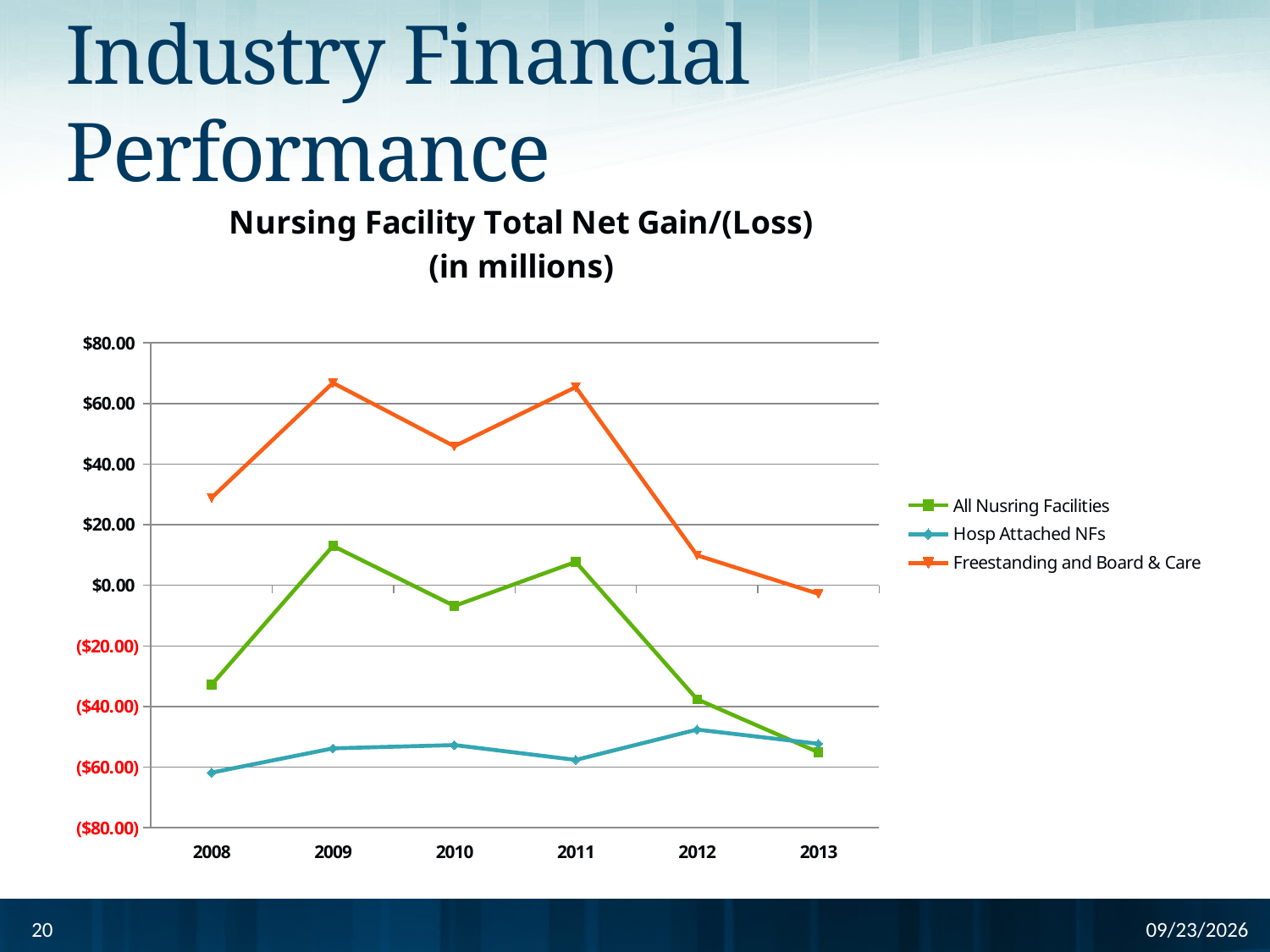
In 2009, which series has the larger value: All Nusring Facilities or Hosp Attached NFs? All Nusring Facilities What kind of chart is shown on the slide? line chart Which year has the lowest value for the Freestanding and Board & Care series? 2013 Is the value for Hosp Attached NFs in 2008 greater or less than ($40.00)? less Does the Freestanding and Board & Care series rise or fall from 2011 to 2013? fall Is the value for Freestanding and Board & Care in 2008 greater or less than $20.00? greater How many series does the legend list? 3 Which year has the highest value for the All Nusring Facilities series? 2009 What is the title of the chart? Nursing Facility Total Net Gain/(Loss) (in millions) How many years are plotted along the x axis? 6 Is the value for Freestanding and Board & Care in 2012 greater or less than $20.00? less Which year has the lowest value for the All Nusring Facilities series? 2013